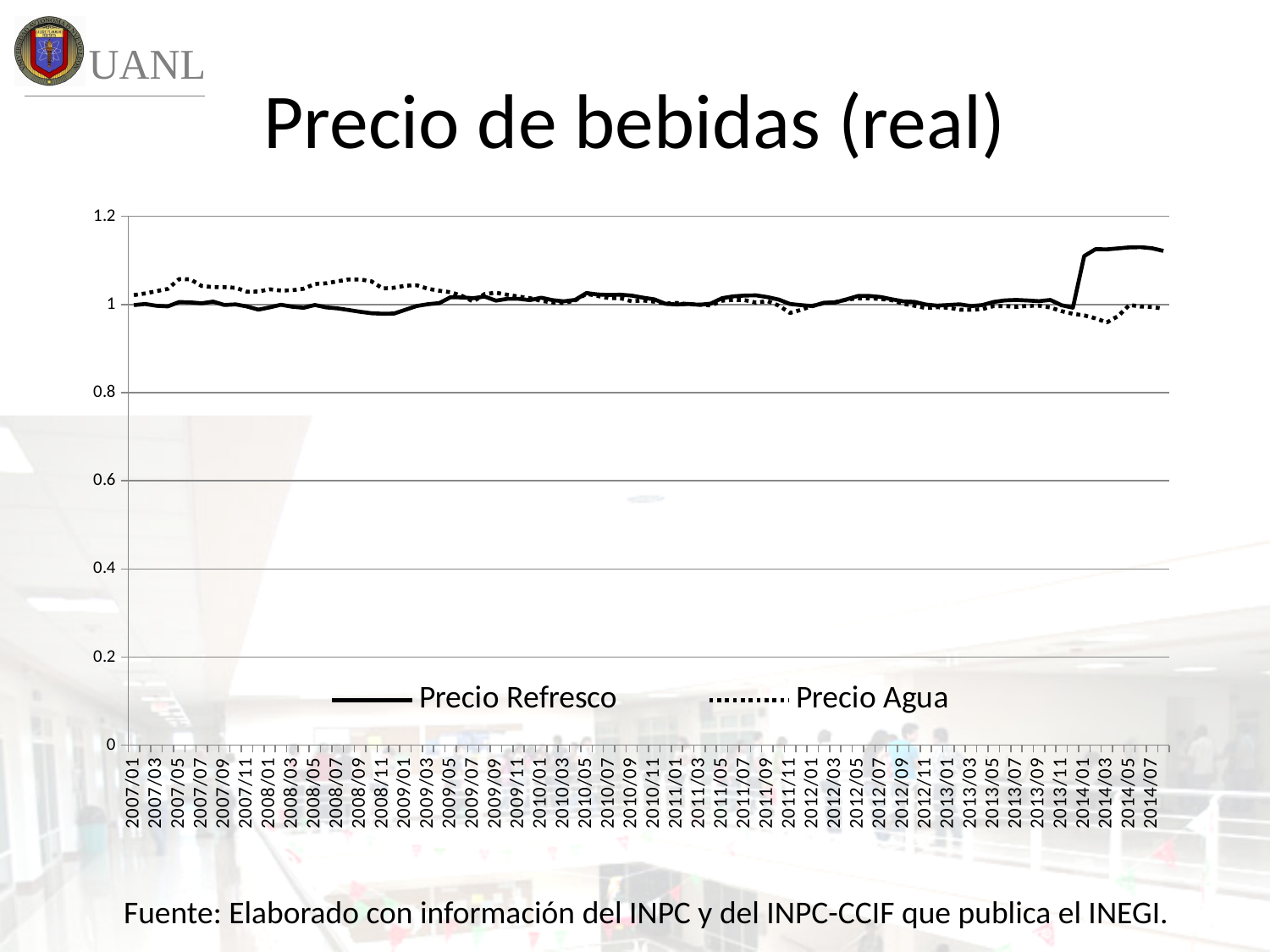
Which series reaches the highest value anywhere on the chart? Precio Refresco Is the value of Precio Refresco at 2014/05 greater or less than 1.2? less What kind of chart is shown on the slide? line chart At 2008/09, which series has the higher value, Precio Refresco or Precio Agua? Precio Agua At 2014/03, which series has the higher value, Precio Refresco or Precio Agua? Precio Refresco What are the two series named in the legend? Precio Refresco and Precio Agua How many series does the legend list? 2 What is the title of the chart? Precio de bebidas (real) Is the value of Precio Refresco at 2014/03 greater or less than 1? greater Is the value of Precio Agua at 2007/05 greater or less than 1? greater Does Precio Refresco rise or fall between 2013/11 and 2014/03? rise